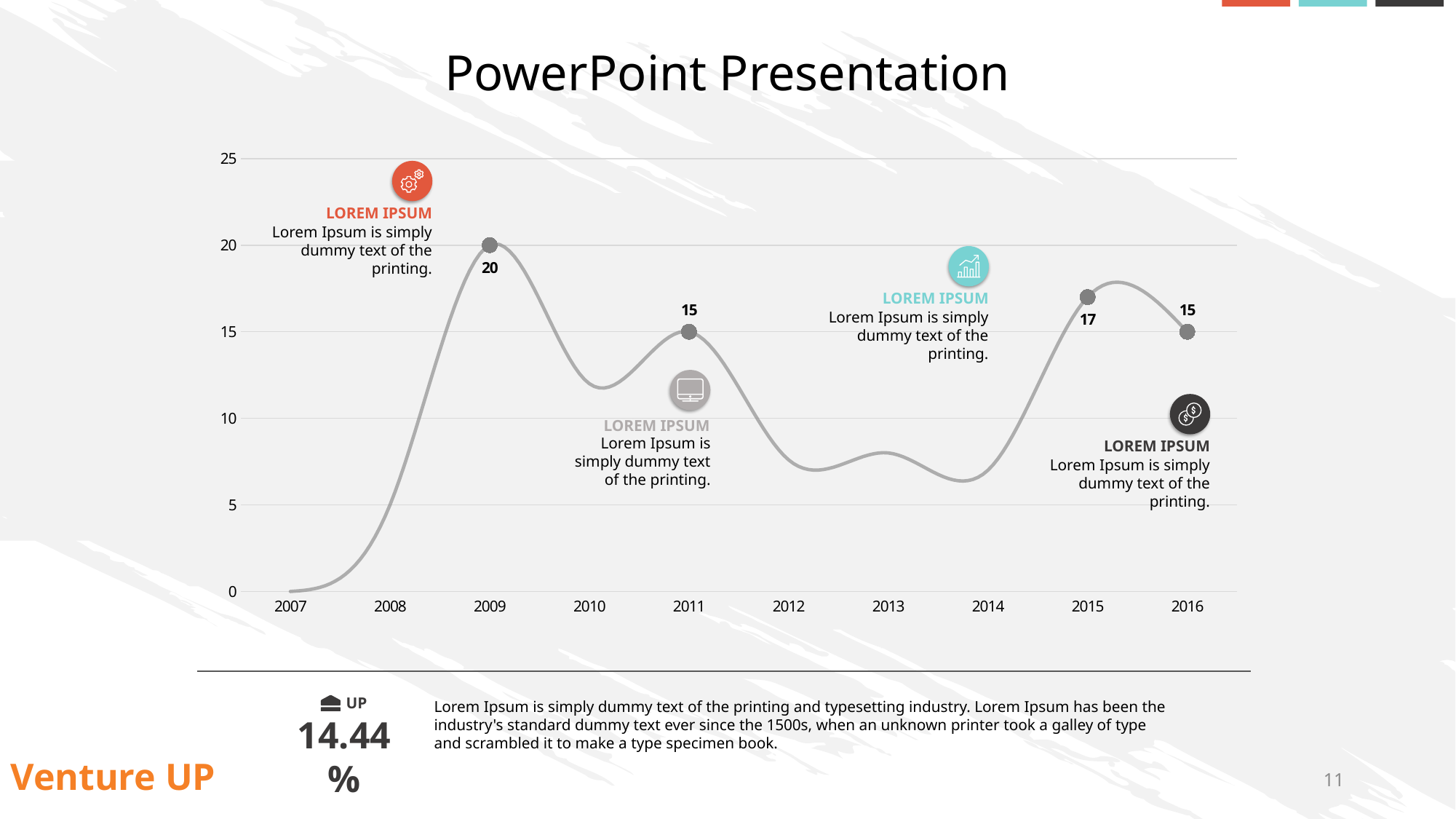
Which year has the highest value on the chart? 2009 What is the value for 2011? 15 What kind of chart is shown on the slide? line chart What is the value for 2009? 20 What is the difference between the values for 2015 and 2016? 2 Is the value for 2010 greater or less than 15? less What is the difference between the values for 2009 and 2015? 3 What is the value for 2016? 15 What is the value for 2015? 17 Is the value for 2012 greater or less than 10? less Which is larger, the value for 2011 or the value for 2015? 2015 How many years are shown on the x axis? 10